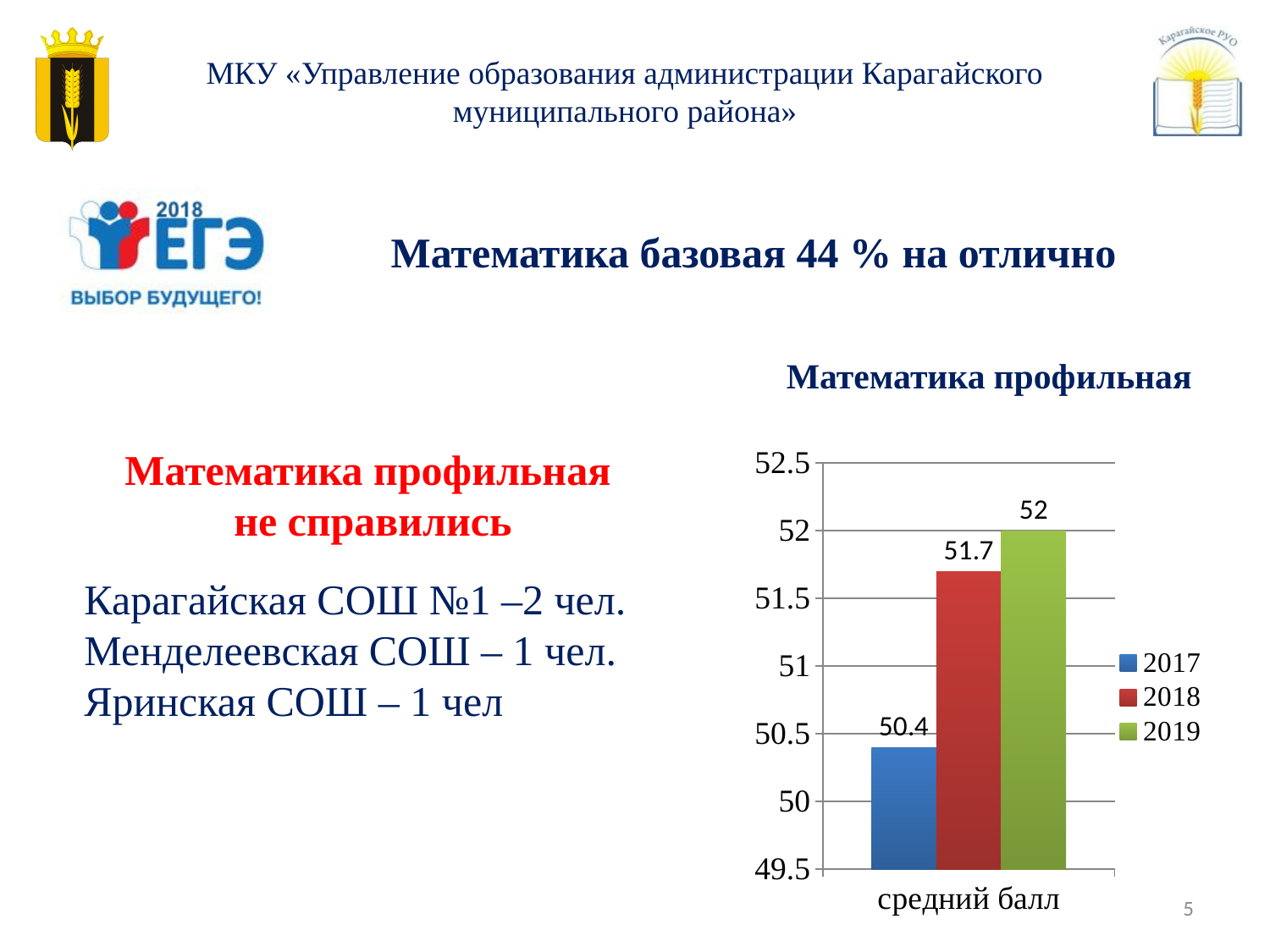
What is the value for 2019 in the chart? 52 What kind of chart is shown on the slide? bar chart What is the value for 2017 in the chart? 50.4 Which year has the lowest average score in the chart? 2017 Is the value for 2017 greater or less than 51? less What is the title of the chart? Математика профильная What is the difference between the 2019 and 2017 values? 1.6 How many series does the legend list? 3 What is the value for 2018 in the chart? 51.7 Which is larger, the value for 2018 or the value for 2017? 2018 What is the difference between the 2018 and 2017 values? 1.3 Which year has the highest average score in the chart? 2019